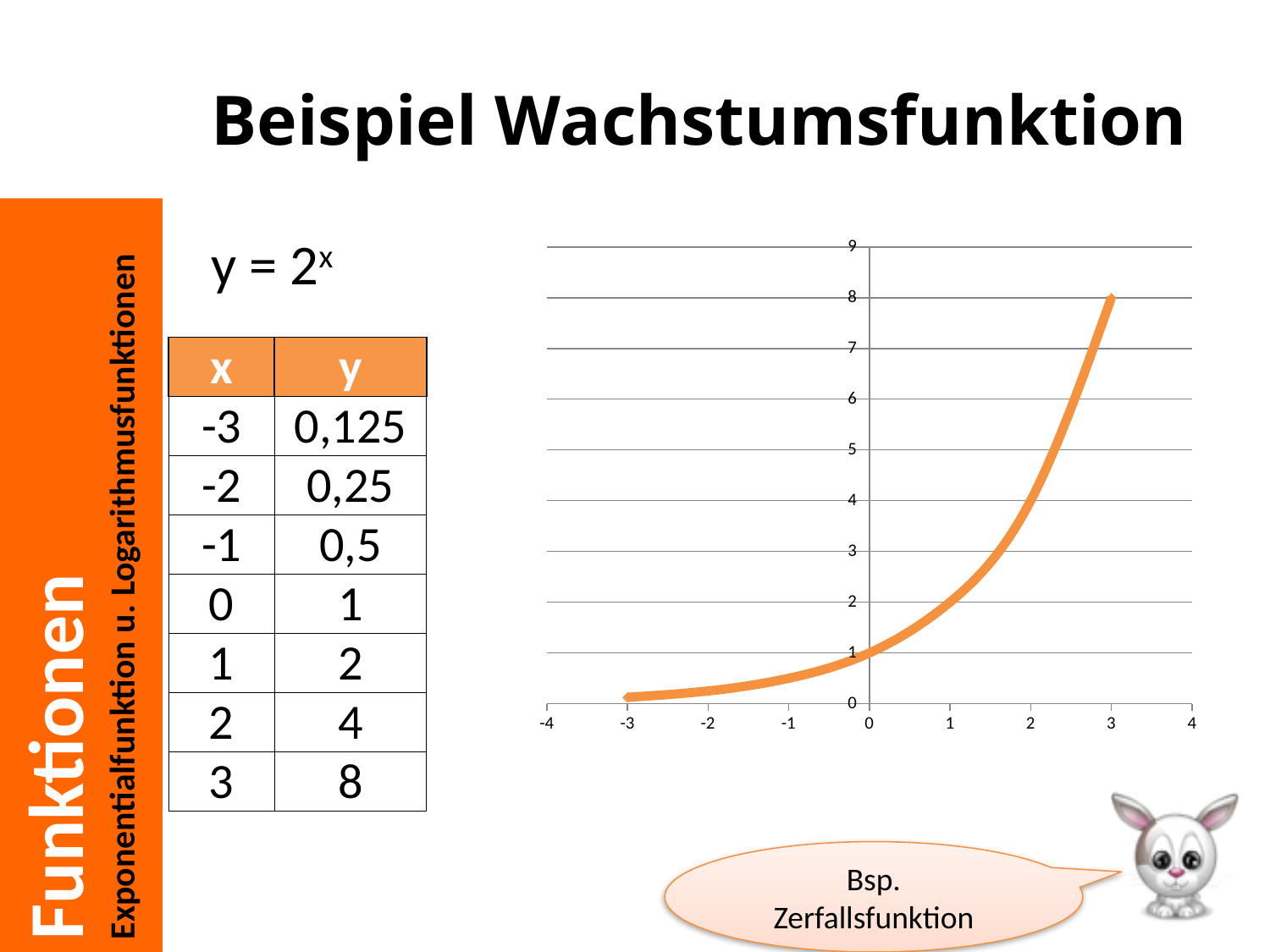
At which x value does the curve have its lowest y value? -3 At which x value does the curve reach its highest y value? 3 What is the y value of the curve at x = 1? 2 What kind of chart is shown on the slide? line chart What is the difference between the y values at x = 3 and x = 2? 4 What is the highest value labelled on the y axis? 9 What is the y value of the curve at x = 3? 8 Is the y value of the curve at x = -1 greater or less than 1? less Do the values on the chart rise or fall as x increases from -3 to 3? rise Which is larger, the y value at x = 3 or the y value at x = -3? x = 3 What is the y value of the curve at x = 2? 4 What is the y value of the curve at x = 0? 1